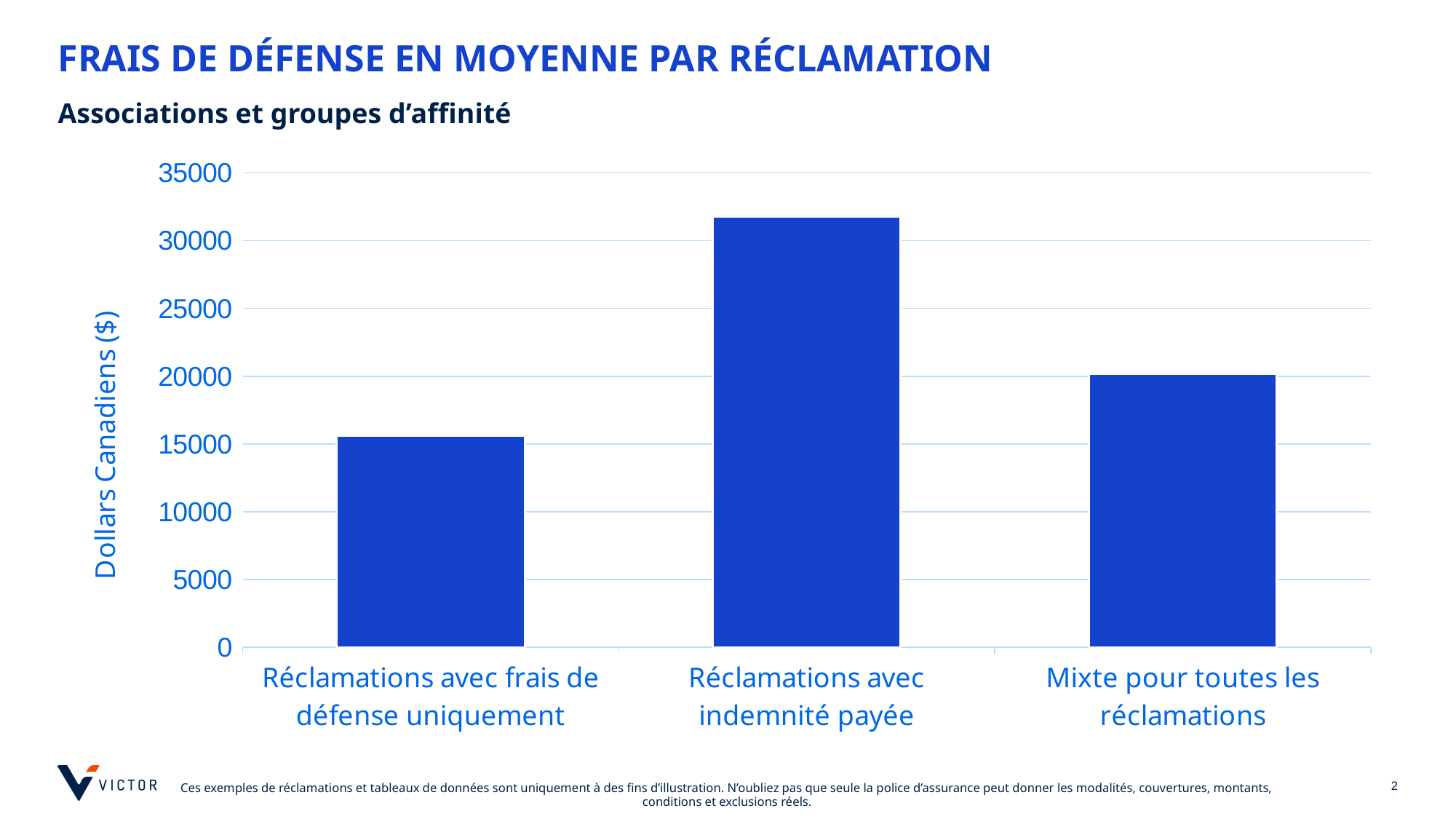
What is the label of the vertical axis of the chart? Dollars Canadiens ($) Is the value for 'Réclamations avec frais de défense uniquement' greater or less than 15000? greater Which category has the lowest average defence cost? Réclamations avec frais de défense uniquement Is the value for 'Réclamations avec indemnité payée' greater or less than 30000? greater How many categories are shown on the x axis of the chart? 3 What kind of chart is shown on the slide? bar chart Which is larger: the value for 'Réclamations avec indemnité payée' or for 'Mixte pour toutes les réclamations'? Réclamations avec indemnité payée What is the title of the chart on the slide? FRAIS DE DÉFENSE EN MOYENNE PAR RÉCLAMATION Which is larger: the value for 'Réclamations avec frais de défense uniquement' or for 'Mixte pour toutes les réclamations'? Mixte pour toutes les réclamations Is the value for 'Mixte pour toutes les réclamations' greater or less than 25000? less Which category has the highest average defence cost? Réclamations avec indemnité payée